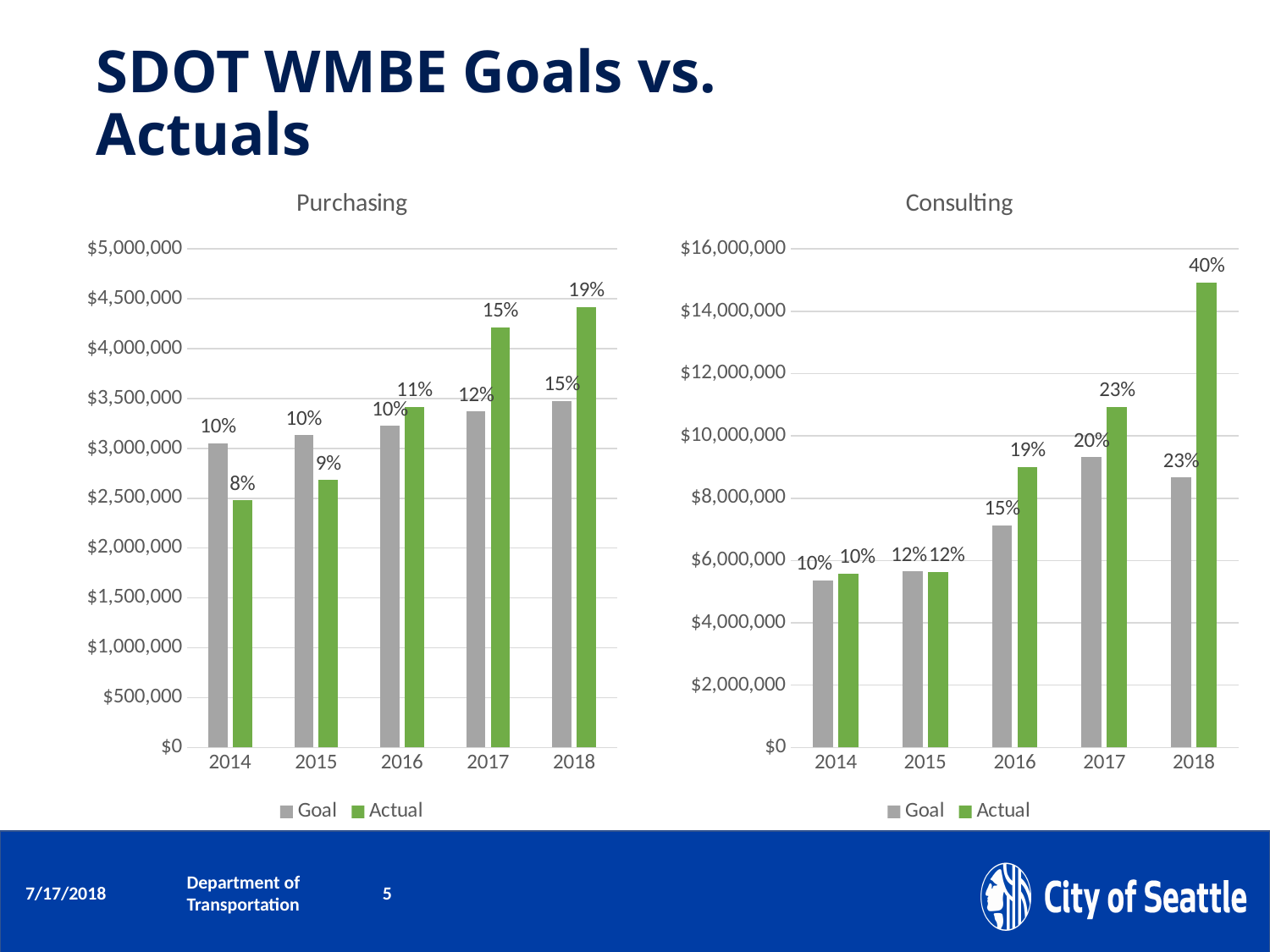
How many years are shown on the x axis of the Consulting chart? 5 In the Consulting chart, by how many percentage points does the 2018 Actual label exceed the 2018 Goal label? 17 percentage points In the Consulting chart, is the Goal bar for 2014 greater or less than $6,000,000? less In the Purchasing chart, which year has the tallest Actual bar? 2018 In the Consulting chart, what percentage label is shown on the Actual bar for 2018? 40% In the Consulting chart, is the Actual bar for 2018 greater or less than $14,000,000? greater In the Purchasing chart, which is taller for 2014, the Goal bar or the Actual bar? Goal In the Purchasing chart, what percentage label is shown on the Actual bar for 2018? 19% In the Consulting chart, do the Actual bars rise or fall from 2014 to 2018? rise In the Consulting chart, what percentage label is shown on the Goal bar for 2016? 15% In the Purchasing chart, which year has the shortest Actual bar? 2014 In the Purchasing chart, what percentage label is shown on the Goal bar for 2017? 12%